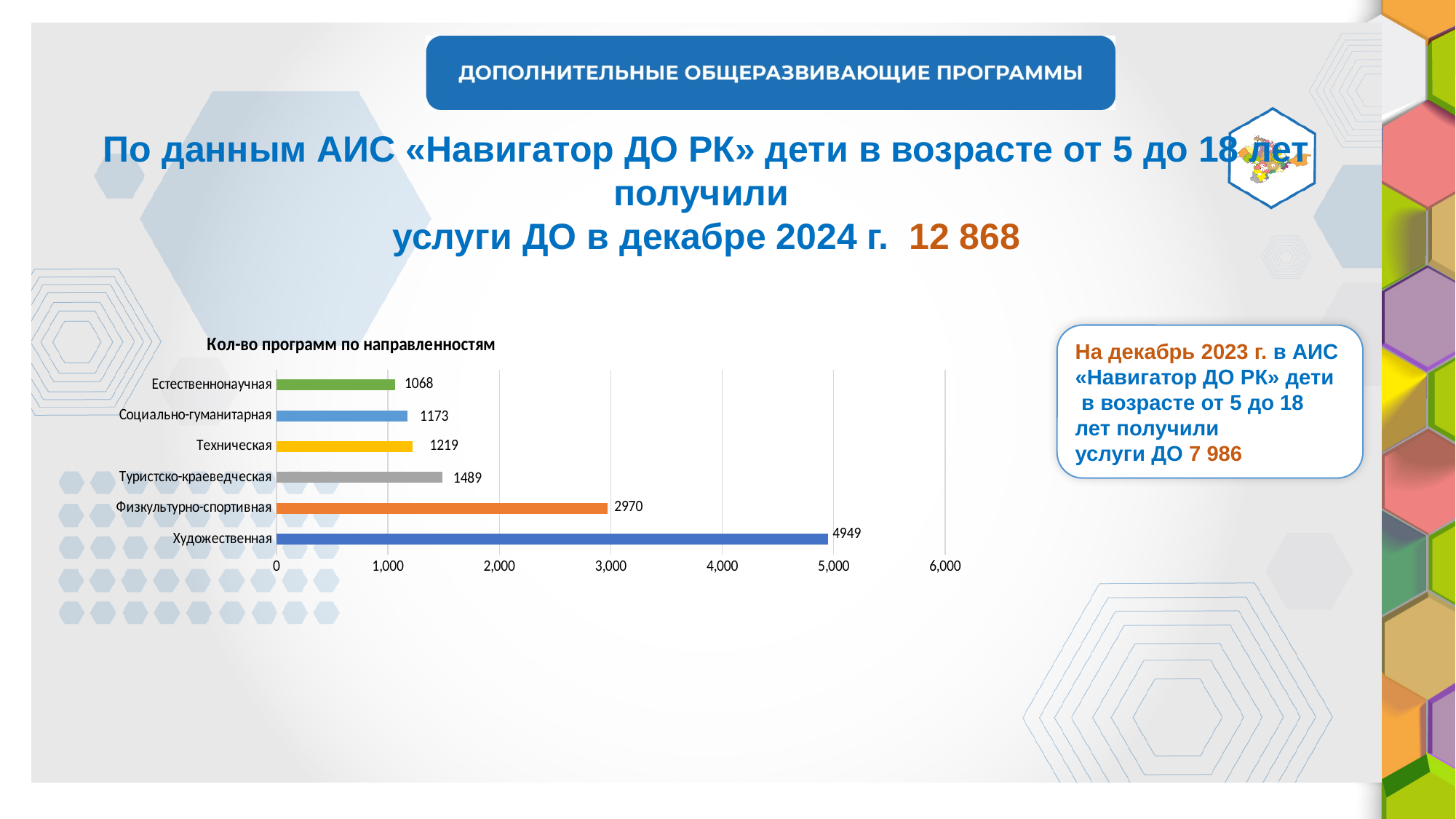
What is the title of the chart? Кол-во программ по направленностям What kind of chart is shown on the slide? bar chart Which category has the lowest value? Естественнонаучная What is the difference between the values for Художественная and Физкультурно-спортивная? 1979 What is the value for Техническая? 1219 Which is larger, the value for Социально-гуманитарная or the value for Естественнонаучная? Социально-гуманитарная How many categories are shown in the chart? 6 Is the value for Физкультурно-спортивная greater or less than 3,000? less What is the value for Художественная in the chart? 4949 What is the value for Физкультурно-спортивная? 2970 Which category has the highest value? Художественная What is the value for Туристско-краеведческая? 1489